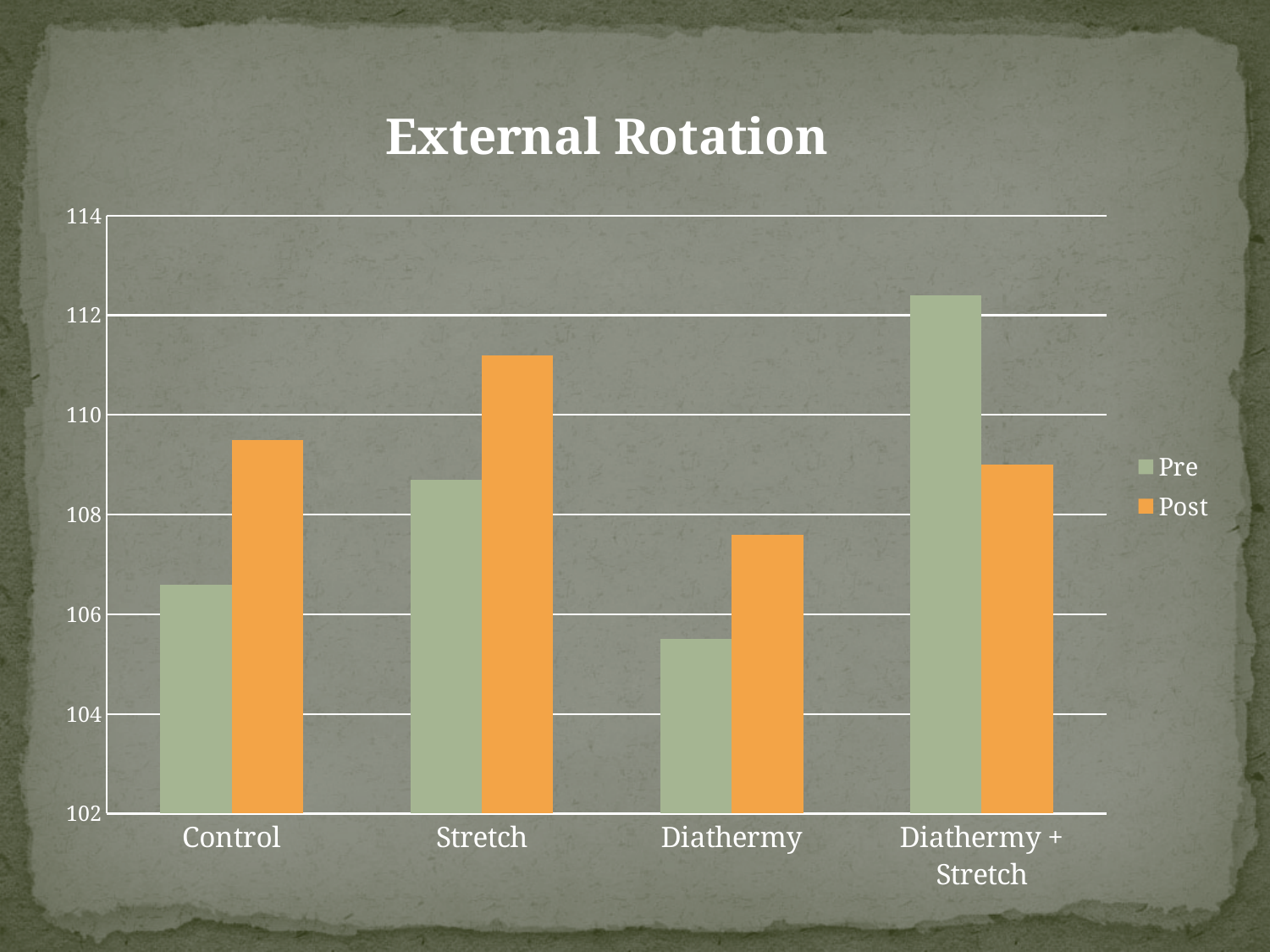
What is the title of the chart? External Rotation Is the Post value for Stretch greater or less than 110? greater What kind of chart is shown on the slide? bar chart For Control, which is larger, the Pre value or the Post value? Post Which category has the highest Pre value? Diathermy + Stretch Which category has the highest Post value? Stretch Which category has the lowest Post value? Diathermy Which category has the lowest Pre value? Diathermy Is the Pre value for Control greater or less than 108? less For Diathermy + Stretch, which is larger, the Pre value or the Post value? Pre How many series does the legend list? 2 How many categories are shown on the x axis? 4